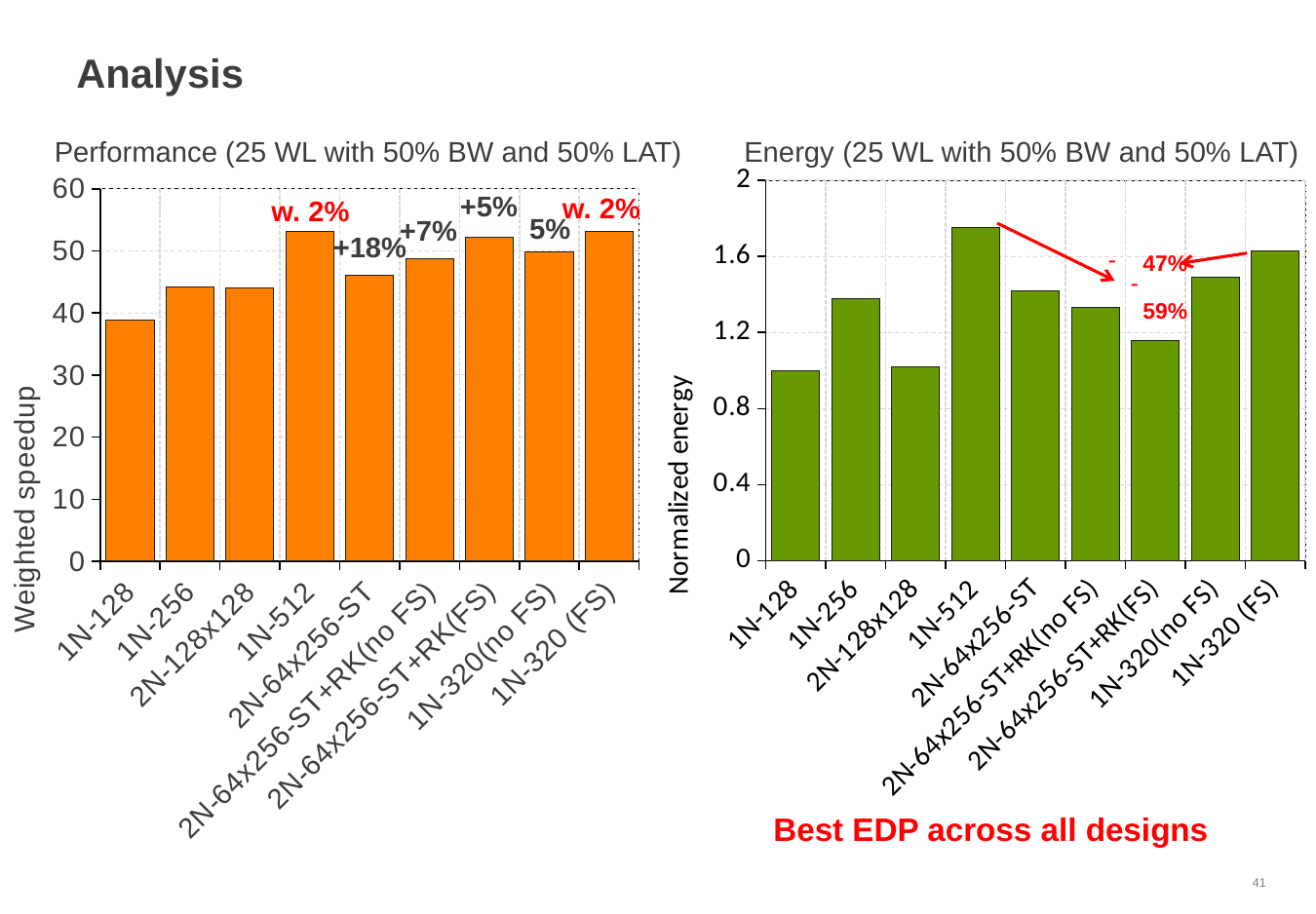
In the Energy chart, which design has the highest normalized energy? 1N-512 In the Performance chart, is the weighted speedup for 1N-512 greater or less than 50? greater In the Performance chart, which design has the lowest weighted speedup? 1N-128 In the Performance chart, how many design categories are shown on the x axis? 9 What kind of chart is the Performance chart on the left? bar chart In the Performance chart, is the weighted speedup for 1N-128 greater or less than 40? less What red text appears below the Energy chart? Best EDP across all designs What is the y-axis label of the Performance chart? Weighted speedup In the Performance chart, which has the higher weighted speedup, 1N-512 or 2N-64x256-ST? 1N-512 In the Energy chart, which has the higher normalized energy, 1N-256 or 2N-128x128? 1N-256 In the Energy chart, is the normalized energy for 1N-512 greater or less than 1.6? greater